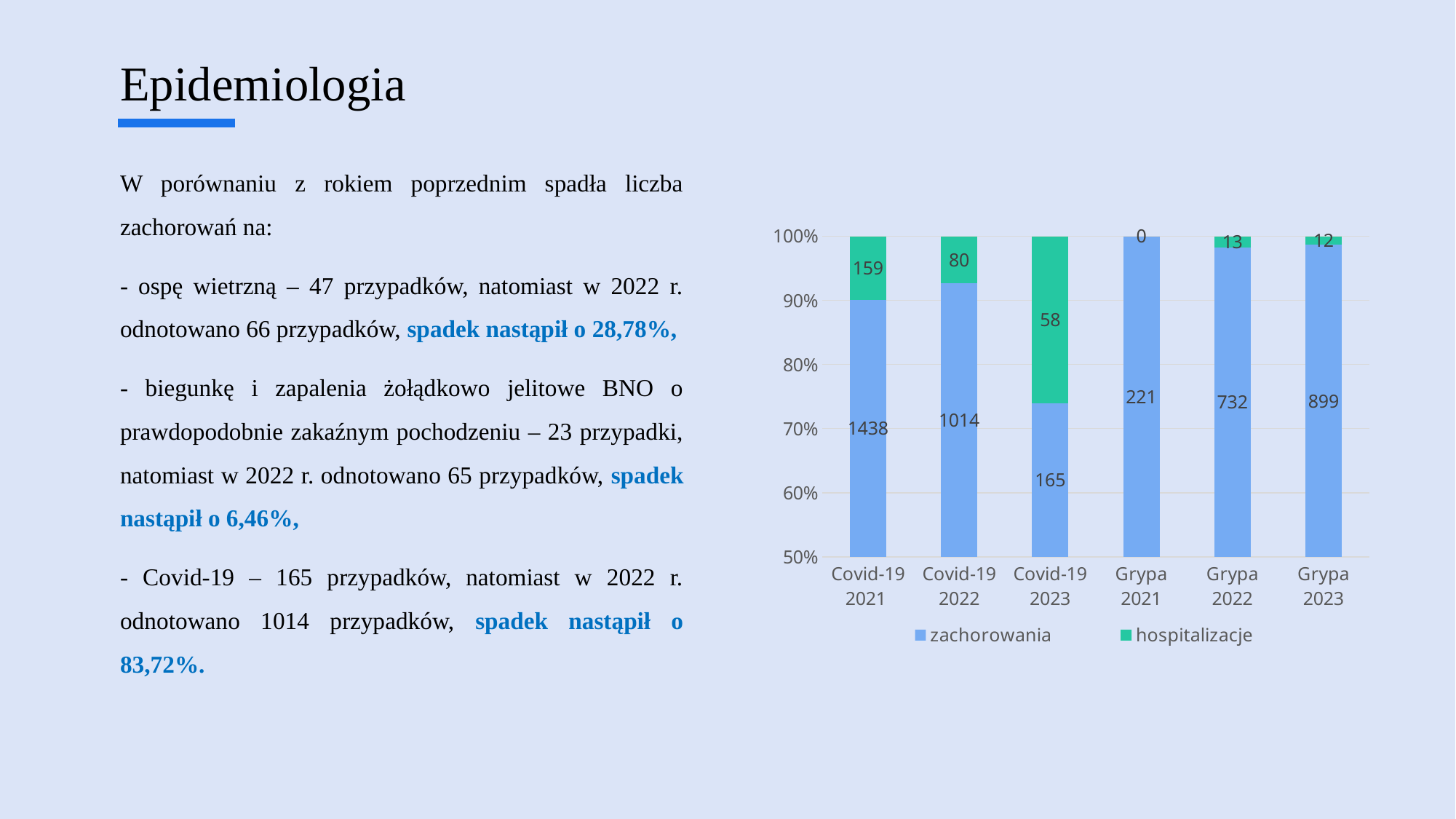
What is the total of zachorowania and hospitalizacje for Grypa 2022? 745 What is the hospitalizacje value for Grypa 2021? 0 What is the zachorowania value for Grypa 2023? 899 How many categories are shown on the x axis? 6 How many series does the legend list? 2 What is the hospitalizacje value for Covid-19 2022? 80 What kind of chart is shown on the slide? Stacked bar chart What is the zachorowania value for Covid-19 2021? 1438 What is the difference between the zachorowania values for Covid-19 2022 and Covid-19 2023? 849 Which category has the highest zachorowania value? Covid-19 2021 Which category has the lowest hospitalizacje value? Grypa 2021 Which is larger, the hospitalizacje value for Covid-19 2021 or for Covid-19 2023? Covid-19 2021